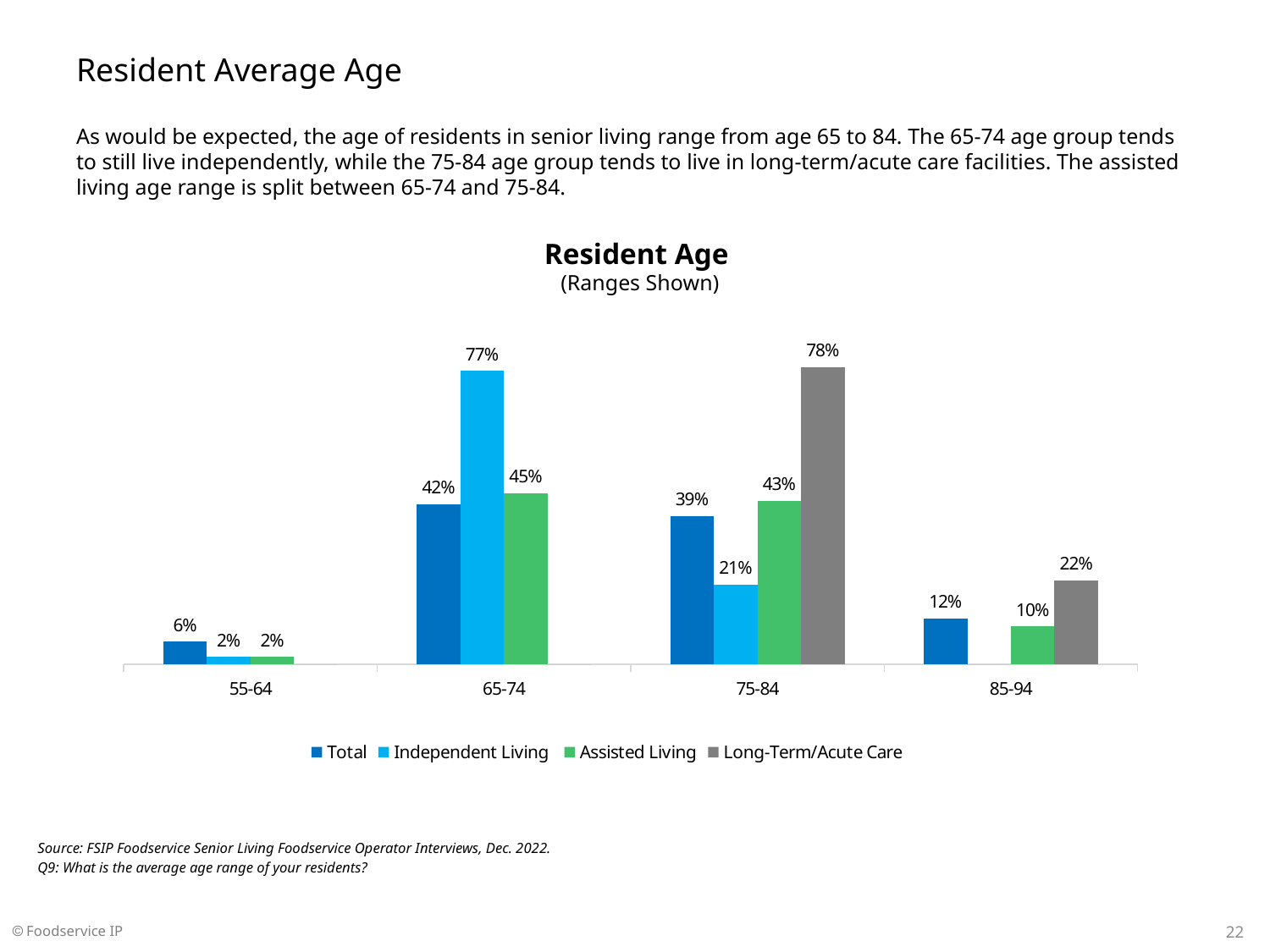
What is the Independent Living value for the 65-74 age range? 77% What is the difference between the Independent Living values for 65-74 and 75-84? 56% What is the title of the chart? Resident Age What is the Long-Term/Acute Care value for the 75-84 age range? 78% What is the Assisted Living value for the 55-64 age range? 2% What is the Total value for the 85-94 age range? 12% What kind of chart is shown? Bar chart How many age ranges are shown on the x axis? 4 How many series does the legend list? 4 Which is larger for the 75-84 age range: Assisted Living or Independent Living? Assisted Living Which age range has the highest Total value? 65-74